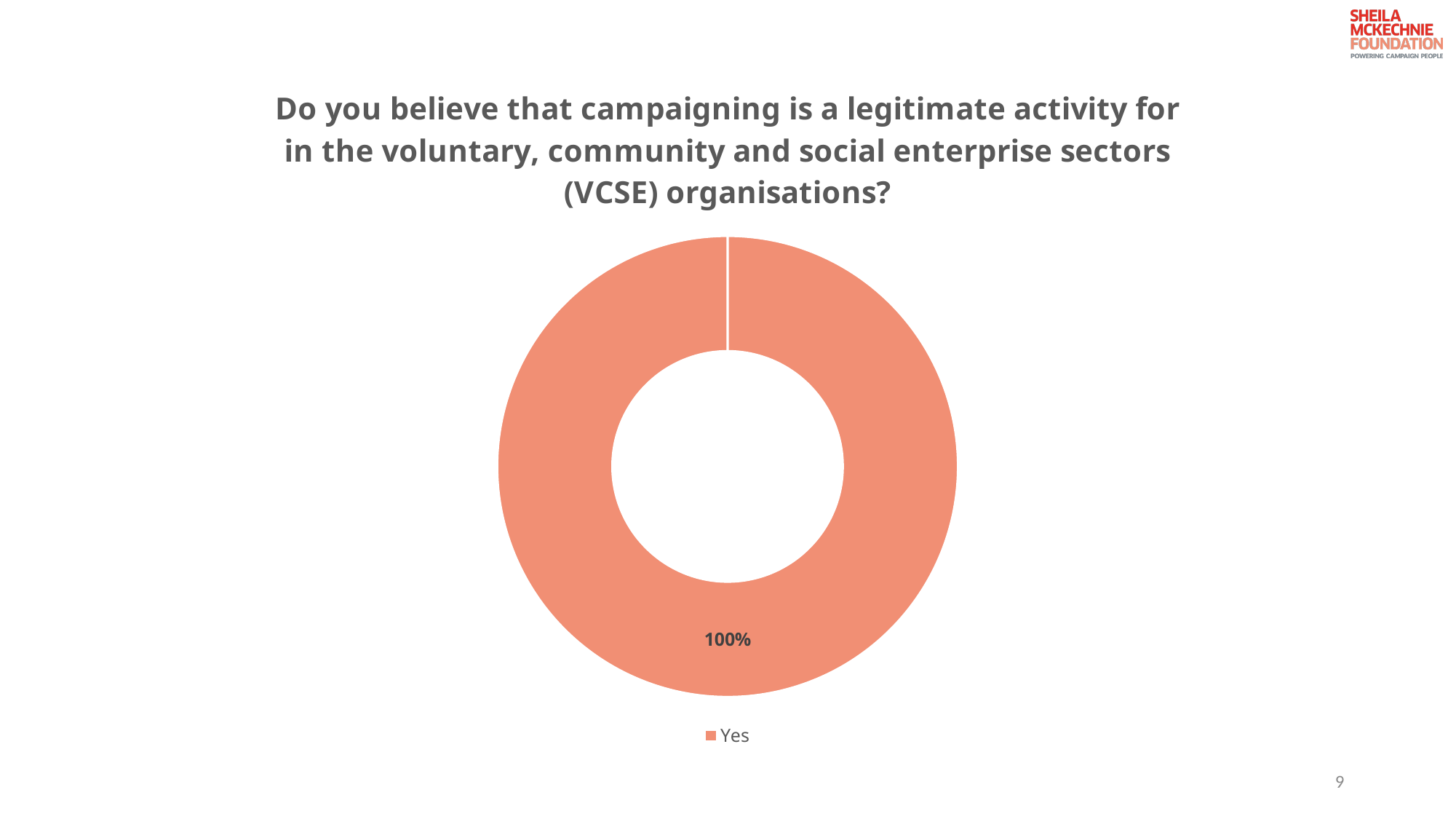
What is the title of the chart? Do you believe that campaigning is a legitimate activity for in the voluntary, community and social enterprise sectors (VCSE) organisations? What share of the chart does the "Yes" slice take up? 100% What is the only legend entry shown for the chart? Yes What kind of chart is shown on the slide? Doughnut chart How many categories does the legend of the chart list? 1 Is the value for "Yes" greater or less than 50%? greater What percentage of respondents answered "Yes" to whether campaigning is a legitimate activity for VCSE organisations? 100%